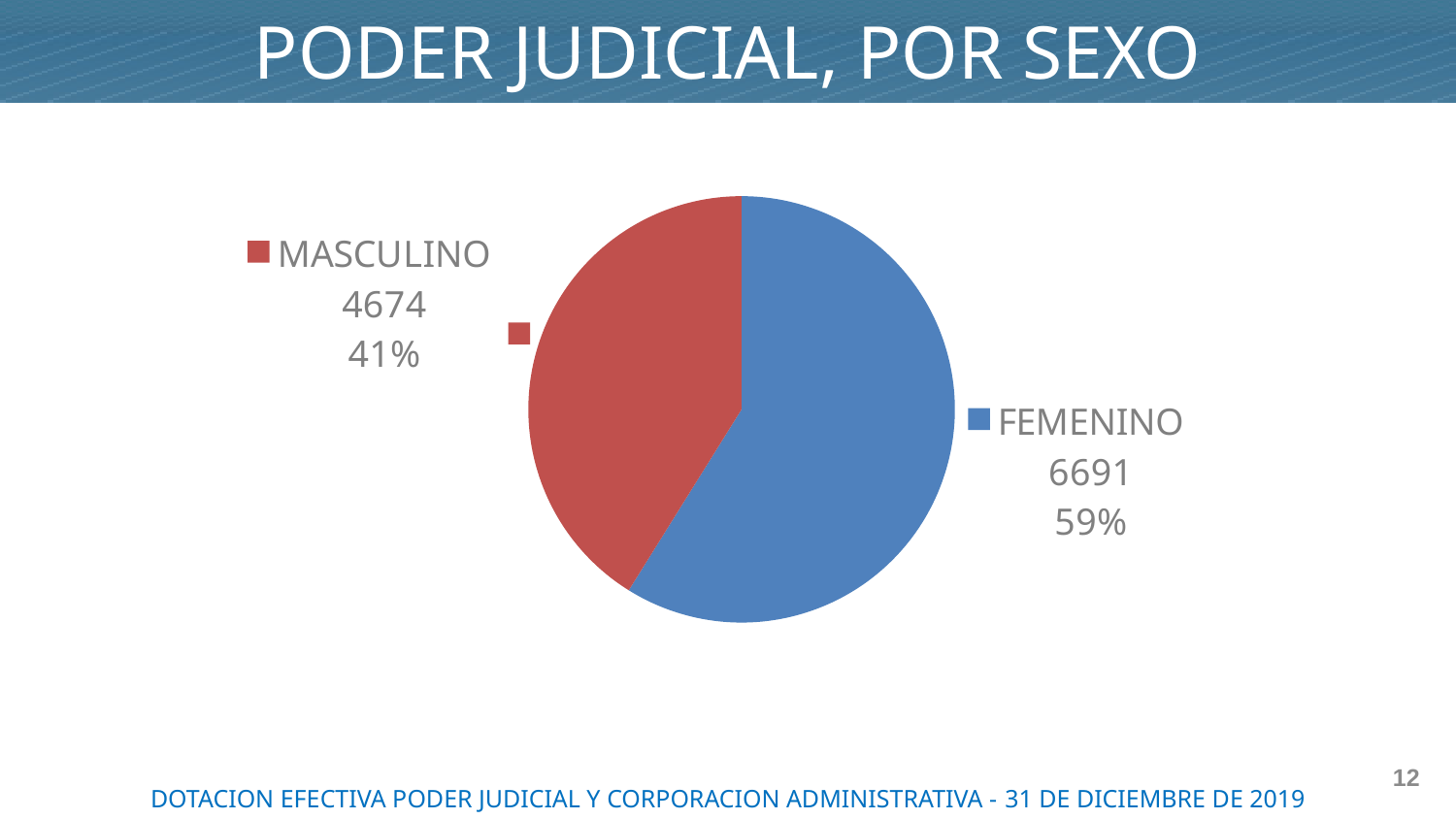
Which category has the smallest slice of the pie? MASCULINO What is the value for FEMENINO? 6691 Which is larger, the value for FEMENINO or the value for MASCULINO? FEMENINO What percentage share of the pie does MASCULINO have? 41% What percentage share of the pie does FEMENINO have? 59% Which category has the largest slice of the pie? FEMENINO What is the value for MASCULINO? 4674 What is the difference between the FEMENINO and MASCULINO values? 2017 How many categories are shown in the pie chart? 2 What kind of chart is shown on the slide? pie chart What colour is the FEMENINO slice? blue What is the total of the two values shown in the pie chart? 11365